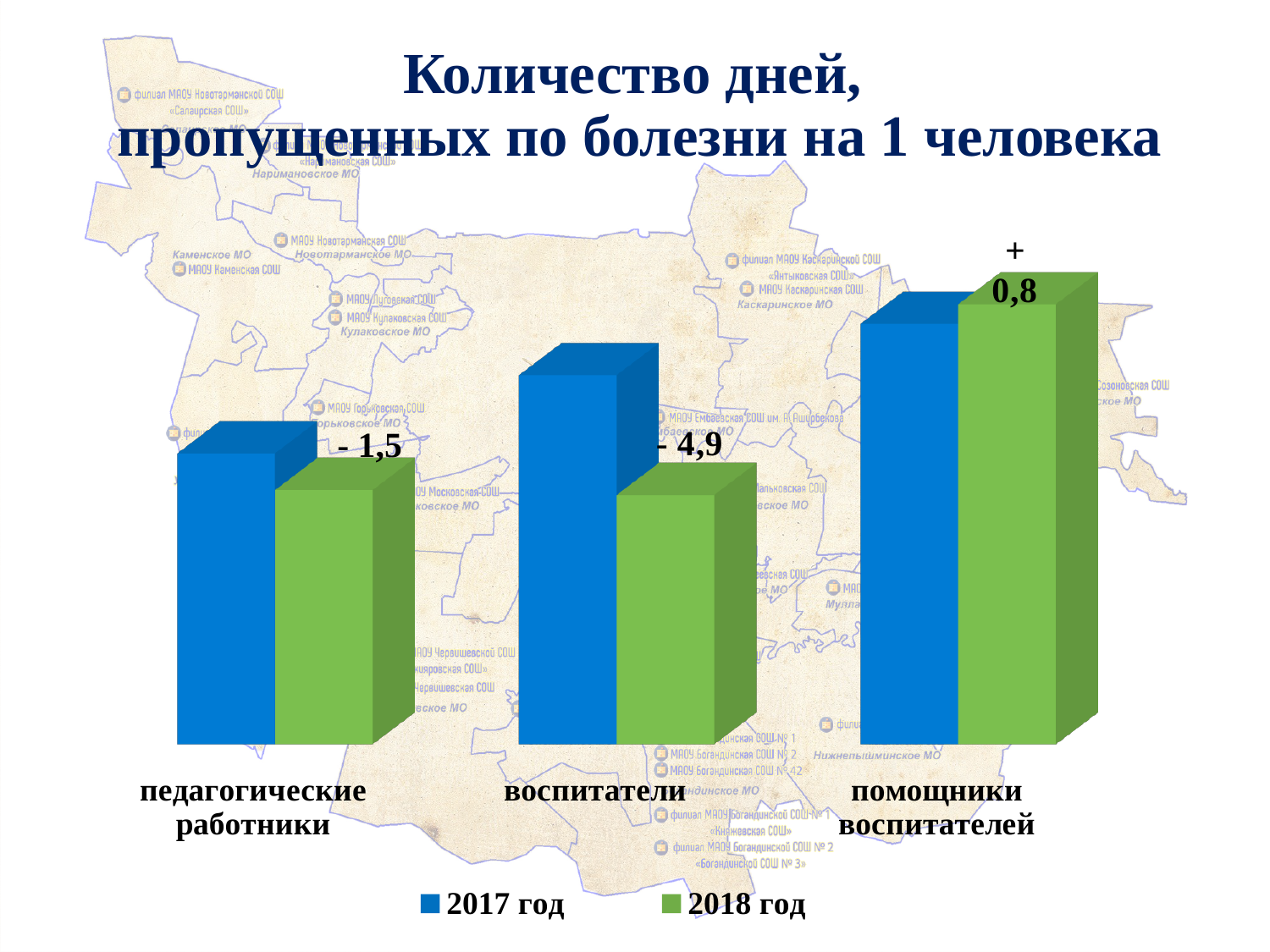
Which category has the lowest value for 2017 год? педагогические работники What change label is printed above the bars for воспитатели? - 4,9 What kind of chart is shown on the slide? bar chart How many series does the legend list? 2 For помощники воспитателей, which year has the taller bar, 2017 год or 2018 год? 2018 год What are the two series named in the legend? 2017 год and 2018 год Which category has the highest value for 2018 год? помощники воспитателей What is the title of the chart? Количество дней, пропущенных по болезни на 1 человека Which category has the highest value for 2017 год? помощники воспитателей How many categories are shown on the x axis of the chart? 3 For воспитатели, which year has the taller bar, 2017 год or 2018 год? 2017 год What change label is printed above the bars for помощники воспитателей? + 0,8